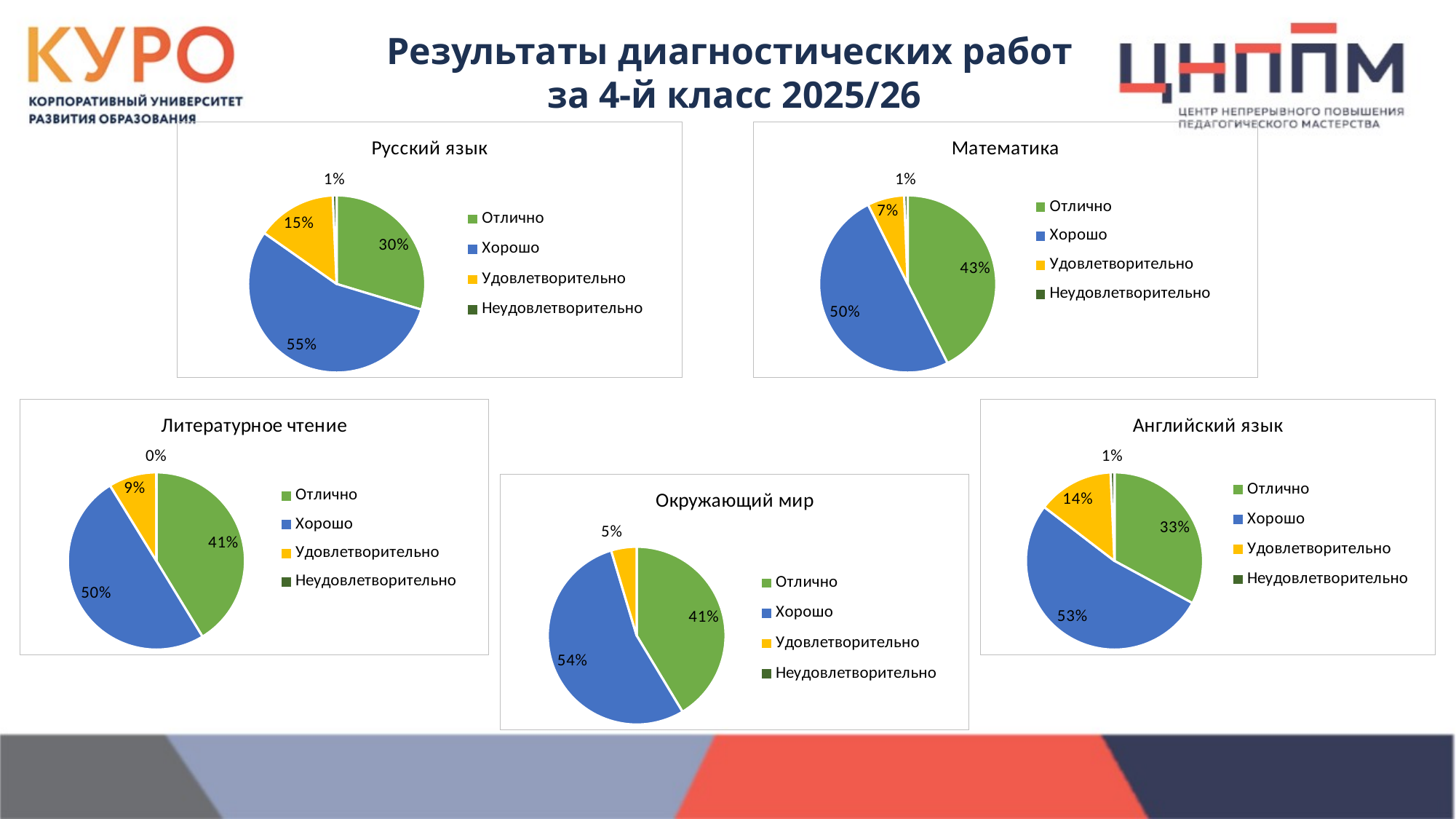
In the "Литературное чтение" chart, which is larger: Отлично or Удовлетворительно? Отлично How many pie charts are shown on the slide? 5 In the "Английский язык" chart, which category has the smallest slice? Неудовлетворительно In the "Математика" chart, what share is labelled for Отлично? 43% In the "Русский язык" chart, what share is labelled for Хорошо? 55% In the "Окружающий мир" chart, what share is labelled for Хорошо? 54% In the "Русский язык" chart, which category has the largest slice? Хорошо How many entries does the legend of the "Математика" chart list? 4 What type of chart is "Окружающий мир"? Pie chart In the "Математика" chart, what is the difference between the Хорошо and Отлично shares? 7% In the "Английский язык" chart, what share is labelled for Удовлетворительно? 14% In the "Литературное чтение" chart, what share is labelled for Удовлетворительно? 9%